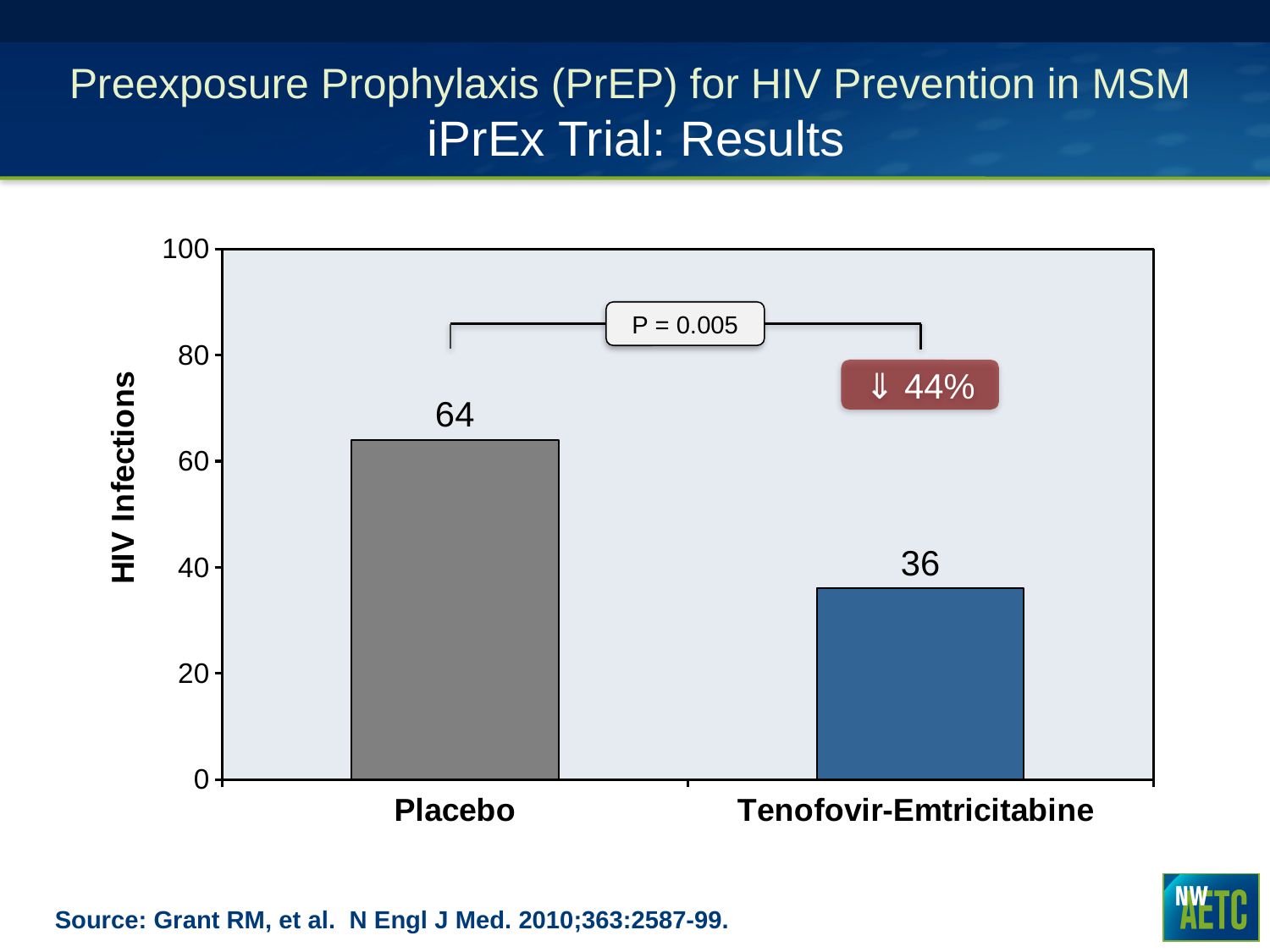
Is the value for Tenofovir-Emtricitabine greater or less than 40? less What is the difference in HIV infections between the Placebo and Tenofovir-Emtricitabine groups? 28 Which group has the lower number of HIV infections? Tenofovir-Emtricitabine How many HIV infections are shown for the Tenofovir-Emtricitabine group? 36 Which group has the higher number of HIV infections? Placebo What kind of chart is shown on the slide? bar chart How many groups (bars) are shown in the chart? 2 What P value is shown comparing the two groups? P = 0.005 Is the number of HIV infections larger for Placebo or for Tenofovir-Emtricitabine? Placebo What is the label of the y axis? HIV Infections How many HIV infections are shown for the Placebo group? 64 Is the value for Placebo greater or less than 60? greater